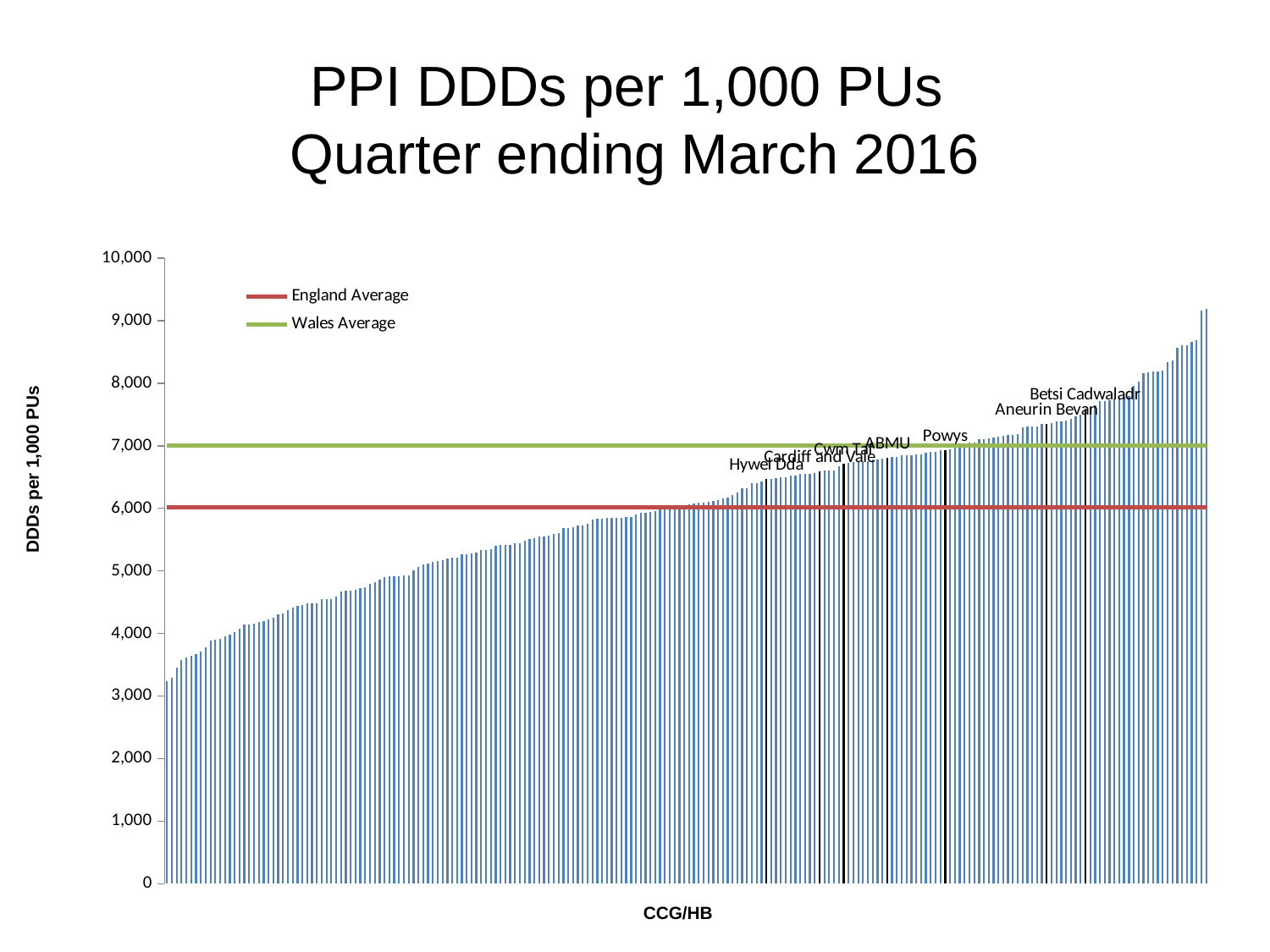
Is the value for Betsi Cadwaladr greater or less than 7,000? greater Which is higher, the Wales Average line or the England Average line? Wales Average Is the value for Aneurin Bevan greater or less than 7,000? greater Is the value for Cardiff and Vale greater or less than 7,000? less Which has the higher value, Betsi Cadwaladr or Hywel Dda? Betsi Cadwaladr Of the labelled Welsh health boards, which has the highest value? Betsi Cadwaladr Do the bar values rise or fall from left to right along the x axis? rise Of the labelled Welsh health boards, which has the lowest value? Hywel Dda What kind of chart is shown on the slide? bar chart How many series does the legend list? 2